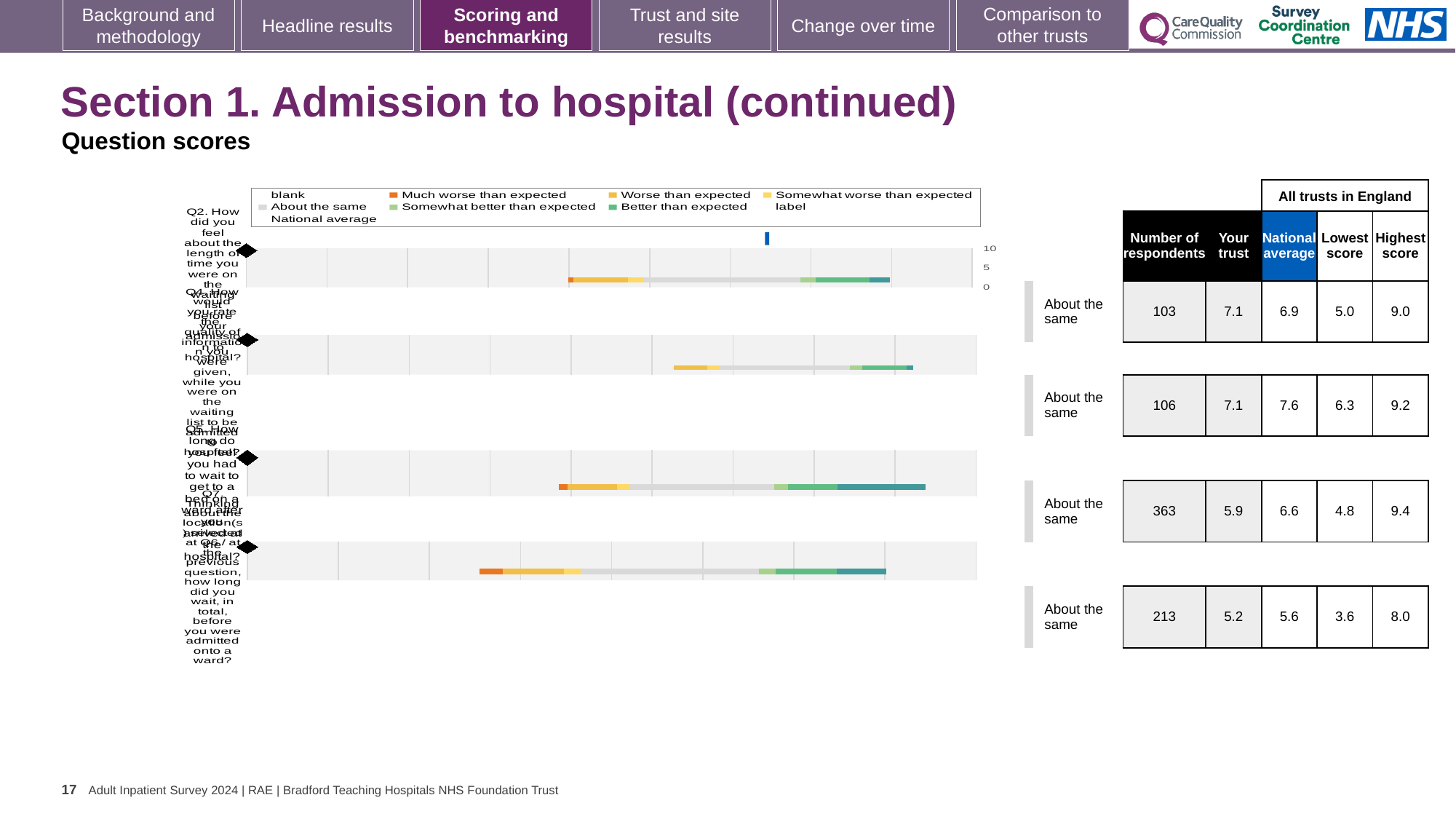
Which question row has the lowest 'Your trust' score? the fourth (bottom) row (5.2) For the third question row, what is the difference between the national average and the 'Your trust' score? 0.7 What is the highest value shown on the chart's score axis? 10 What benchmark label is shown for every question row in the chart? About the same How many question rows (bars) are plotted in the chart? 4 What is the 'Your trust' score for the fourth (bottom) question row? 5.2 How many respondents are listed for the third question row? 363 Which question row has the highest number of respondents? the third row (363) What kind of chart is shown on the slide? bar chart What is the national average for the second question row? 7.6 What is the 'Your trust' score for the first (top) question row? 7.1 For the fourth question row, which is larger: the 'Your trust' score or the national average? the national average (5.6)